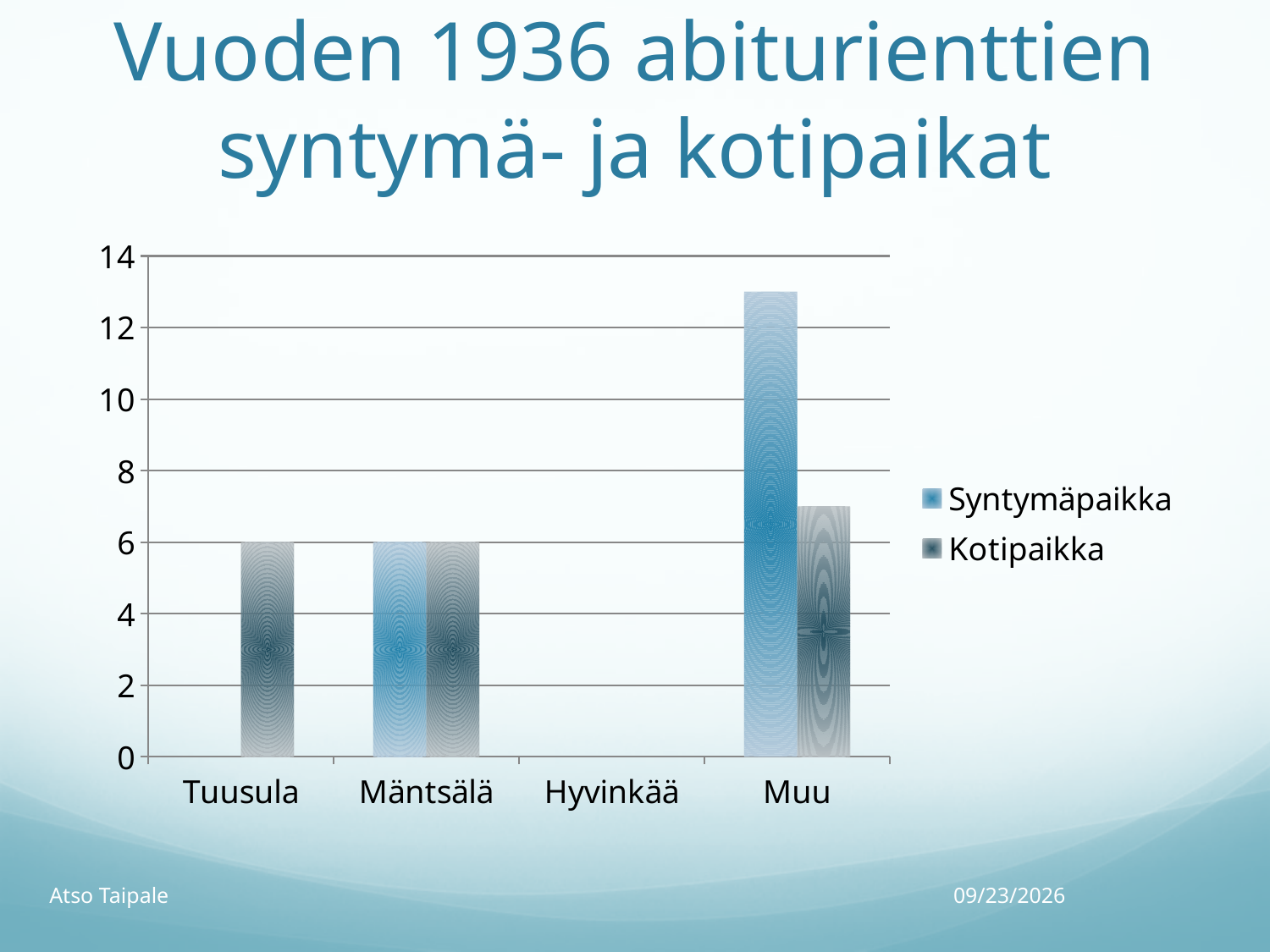
How many categories are shown on the x axis? 4 Is the Kotipaikka value for Muu greater or less than 8? less What is the Kotipaikka value for Mäntsälä? 6 What kind of chart is shown on the slide? bar chart How many series does the legend list? 2 Which category has the highest Syntymäpaikka value? Muu What is the Kotipaikka value for Tuusula? 6 What is the Syntymäpaikka value for Mäntsälä? 6 Is the Syntymäpaikka value for Muu greater or less than 12? greater What are the two series named in the legend? Syntymäpaikka and Kotipaikka Which category has the highest Kotipaikka value? Muu For Muu, which series has the larger value, Syntymäpaikka or Kotipaikka? Syntymäpaikka